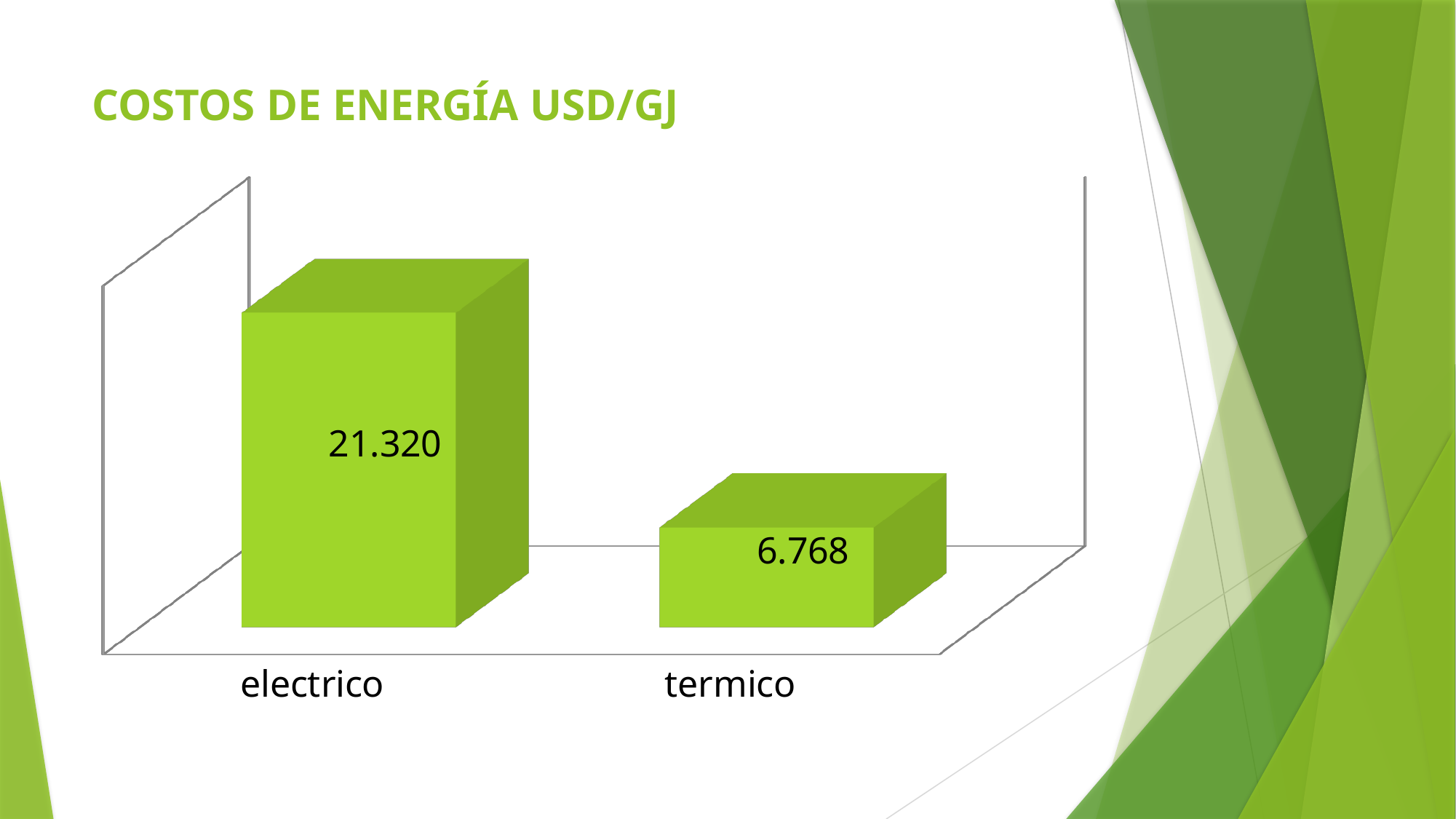
Which is larger, the value for electrico or the value for termico? electrico What is the value shown for termico? 6.768 Which category has the lowest value? termico How many categories are shown in the chart? 2 What colour are the bars in the chart? green What is the value shown for electrico? 21.320 Which category has the highest value? electrico What is the difference between the values for electrico and termico? 14.552 Do the values rise or fall from electrico to termico? fall What kind of chart is shown on the slide? bar chart What is the title of the slide? COSTOS DE ENERGÍA USD/GJ